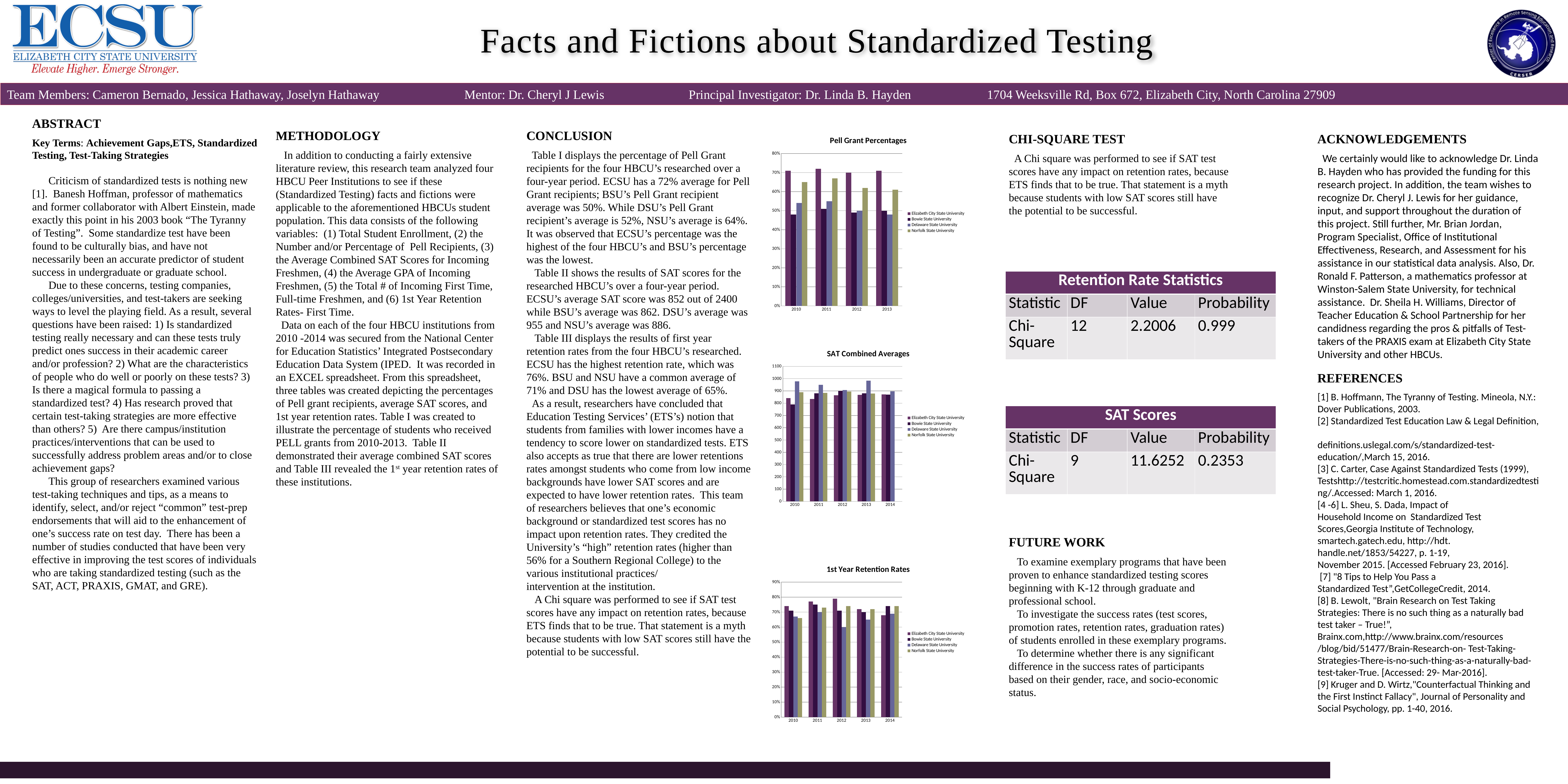
In the '1st Year Retention Rates' chart, is the value for Elizabeth City State University in 2012 greater or less than 70%? greater In the 'Pell Grant Percentages' chart, is the value for Elizabeth City State University in 2011 greater or less than 60%? greater What kind of chart is the 'Pell Grant Percentages' chart? bar chart In the 'SAT Combined Averages' chart, is the value for Bowie State University in 2010 greater or less than 900? less How many years are shown on the x axis of the 'SAT Combined Averages' chart? 5 In the '1st Year Retention Rates' chart, which university has the lowest value in 2012? Delaware State University How many series does the legend of the 'SAT Combined Averages' chart list? 4 How many years are shown on the x axis of the 'Pell Grant Percentages' chart? 4 In the 'Pell Grant Percentages' chart, which is larger in 2013: Norfolk State University or Bowie State University? Norfolk State University In the 'Pell Grant Percentages' chart, which university has the highest value in 2010? Elizabeth City State University In the 'SAT Combined Averages' chart, which university has the highest value in 2010? Delaware State University